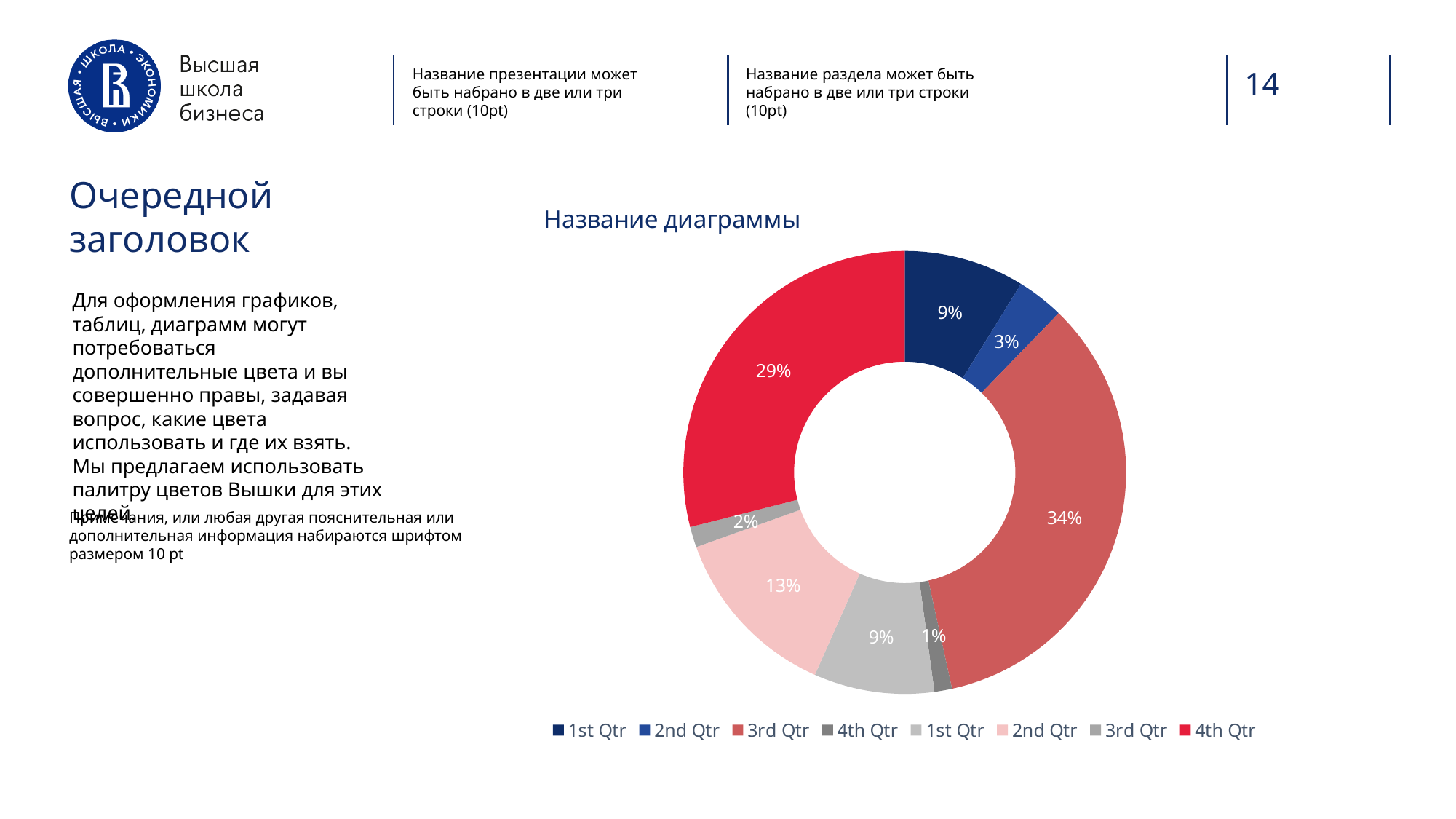
How many slices does the doughnut chart have? 8 What is the value of the largest slice in the chart? 34% What percentage is shown on the dark navy slice at the top of the doughnut? 9% How many entries does the chart legend list? 8 What kind of chart is shown on the slide? doughnut (pie) chart What is the value of the smallest slice in the chart? 1% What is the title of the chart? Название диаграммы Which slice is larger: the pale pink slice (13%) or the light grey slice (9%)? the pale pink slice (13%) What percentage is shown on the bright red slice on the left side of the doughnut? 29% What is the difference between the largest slice (34%) and the bright red slice (29%)? 5 percentage points What is the combined share of the two largest slices (34% and 29%)? 63% How many slices in the chart are labelled 9%? 2